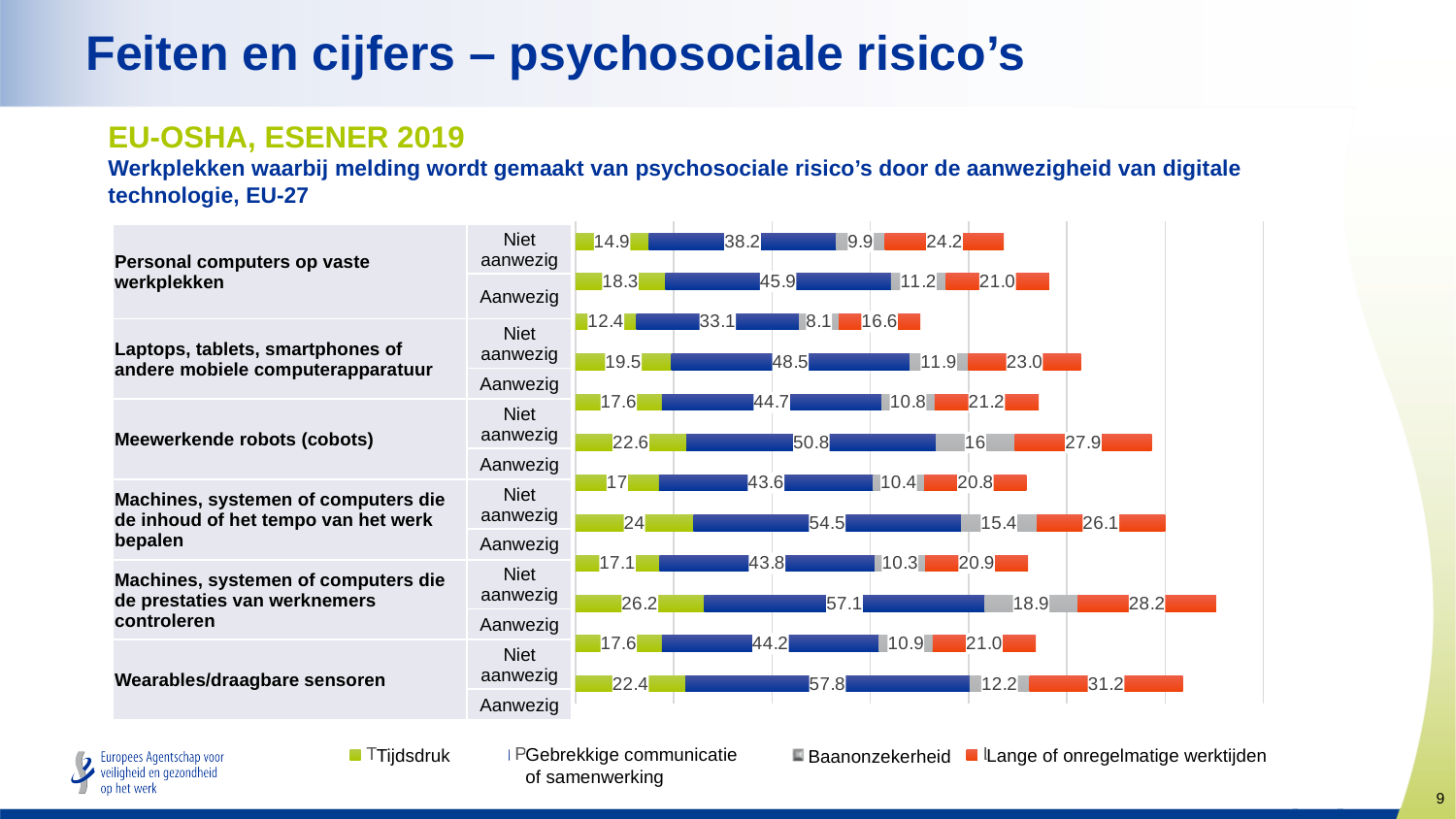
What kind of chart is shown on the slide? Stacked horizontal bar chart How many stacked bars are plotted in the chart? 12 Which bar has the lowest value for Gebrekkige communicatie of samenwerking? Laptops, tablets, smartphones of andere mobiele computerapparatuur – Niet aanwezig (33.1) What is the value for Gebrekkige communicatie of samenwerking for 'Wearables/draagbare sensoren' when Aanwezig? 57.8 Which bar has the highest value for Tijdsdruk? Machines, systemen of computers die de prestaties van werknemers controleren – Aanwezig (26.2) How many series does the legend list? 4 What is the total of the stacked bar for 'Laptops, tablets, smartphones of andere mobiele computerapparatuur' – Niet aanwezig? 70.2 What is the value for Baanonzekerheid for 'Laptops, tablets, smartphones of andere mobiele computerapparatuur' when Niet aanwezig? 8.1 For 'Machines, systemen of computers die de inhoud of het tempo van het werk bepalen', is Tijdsdruk higher when Aanwezig or Niet aanwezig? Aanwezig What is the value for Tijdsdruk for 'Personal computers op vaste werkplekken' when the technology is Aanwezig? 18.3 What is the value for Lange of onregelmatige werktijden for 'Meewerkende robots (cobots)' when Aanwezig? 27.9 What is the difference in Gebrekkige communicatie of samenwerking for 'Wearables/draagbare sensoren' between Aanwezig and Niet aanwezig? 13.6